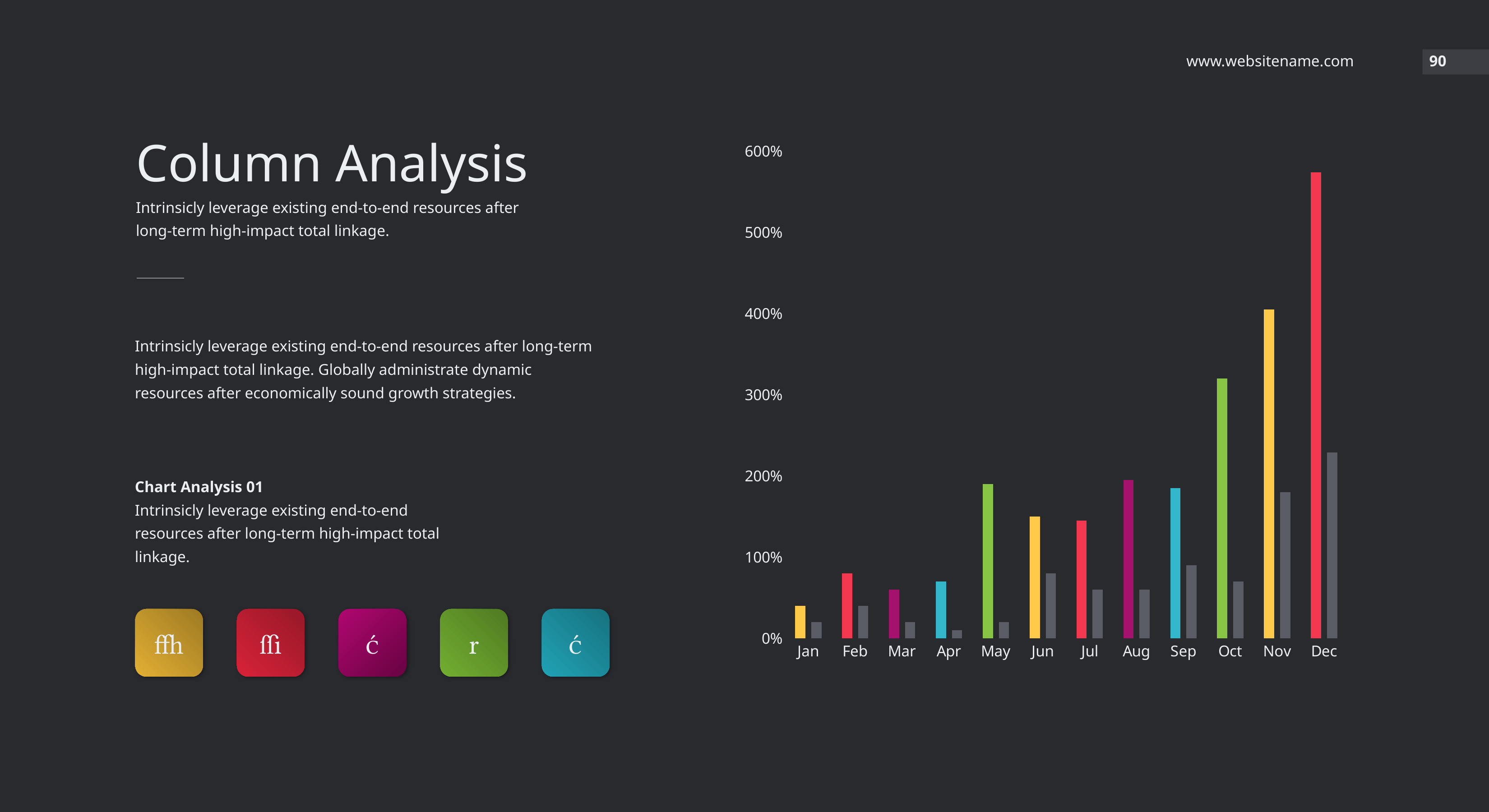
Which month has the tallest coloured bar? Dec Do the coloured bars generally rise or fall from Jan to Dec? rise Is the coloured bar for Oct greater or less than 300%? greater Is the coloured bar for Dec greater or less than 500%? greater What kind of chart is shown on the slide? bar chart Is the coloured bar for Nov greater or less than 500%? less Which month has the tallest grey bar? Dec What is the title of the slide containing the chart? Column Analysis Which is taller, the coloured bar for Oct or the coloured bar for Nov? Nov Which month has the shortest coloured bar? Jan How many months are shown on the x axis of the chart? 12